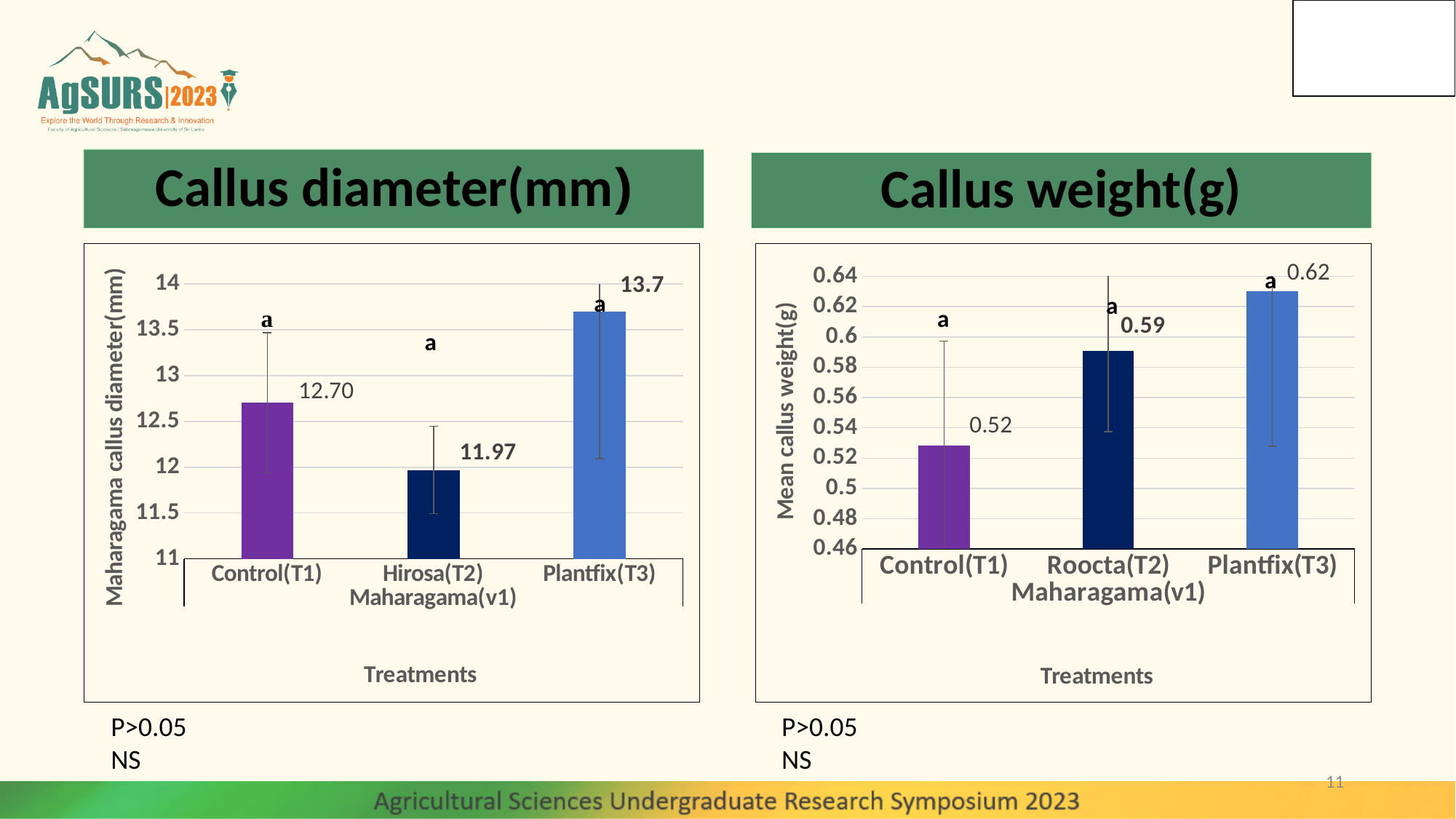
In the Callus diameter(mm) chart, how many treatments are plotted? 3 In the Callus weight(g) chart, what is the difference between the values for Plantfix(T3) and Control(T1)? 0.10 In the Callus weight(g) chart, what is the value for Plantfix(T3)? 0.62 In the Callus diameter(mm) chart, what is the difference between the values for Plantfix(T3) and Hirosa(T2)? 1.73 In the Callus weight(g) chart, is the value for Roocta(T2) larger or smaller than the value for Control(T1)? larger In the Callus diameter(mm) chart, what is the value for Hirosa(T2)? 11.97 In the Callus diameter(mm) chart, which treatment has the lowest callus diameter? Hirosa(T2) In the Callus weight(g) chart, which treatment has the lowest mean callus weight? Control(T1) What kind of chart is the Callus weight(g) chart? bar chart In the Callus diameter(mm) chart, which treatment has the highest callus diameter? Plantfix(T3) In the Callus diameter(mm) chart, what is the value for Control(T1)? 12.70 In the Callus weight(g) chart, what is the value for Roocta(T2)? 0.59